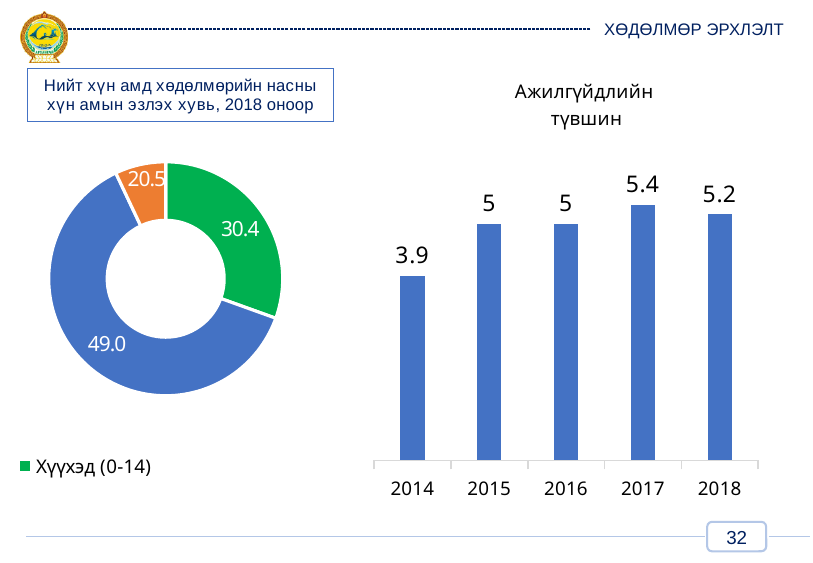
In the bar chart titled "Ажилгүйдлийн түвшин", which year has the lowest value? 2014 In the bar chart titled "Ажилгүйдлийн түвшин", what is the value for 2018? 5.2 In the bar chart titled "Ажилгүйдлийн түвшин", which year has the highest value? 2017 In the doughnut chart on the left of the slide, what is the value of the largest slice? 49.0 What kind of chart is the chart on the right of the slide, titled "Ажилгүйдлийн түвшин"? bar chart In the doughnut chart on the left of the slide, what is the value of the green slice labelled "Хүүхэд (0-14)"? 30.4 In the bar chart titled "Ажилгүйдлийн түвшин", what is the value for 2014? 3.9 In the bar chart titled "Ажилгүйдлийн түвшин", what is the difference between the values for 2017 and 2014? 1.5 What kind of chart is the chart on the left of the slide? doughnut chart In the bar chart titled "Ажилгүйдлийн түвшин", which is larger, the value for 2015 or the value for 2018? 2018 How many years are shown in the bar chart titled "Ажилгүйдлийн түвшин"? 5 In the bar chart titled "Ажилгүйдлийн түвшин", what is the value for 2017? 5.4